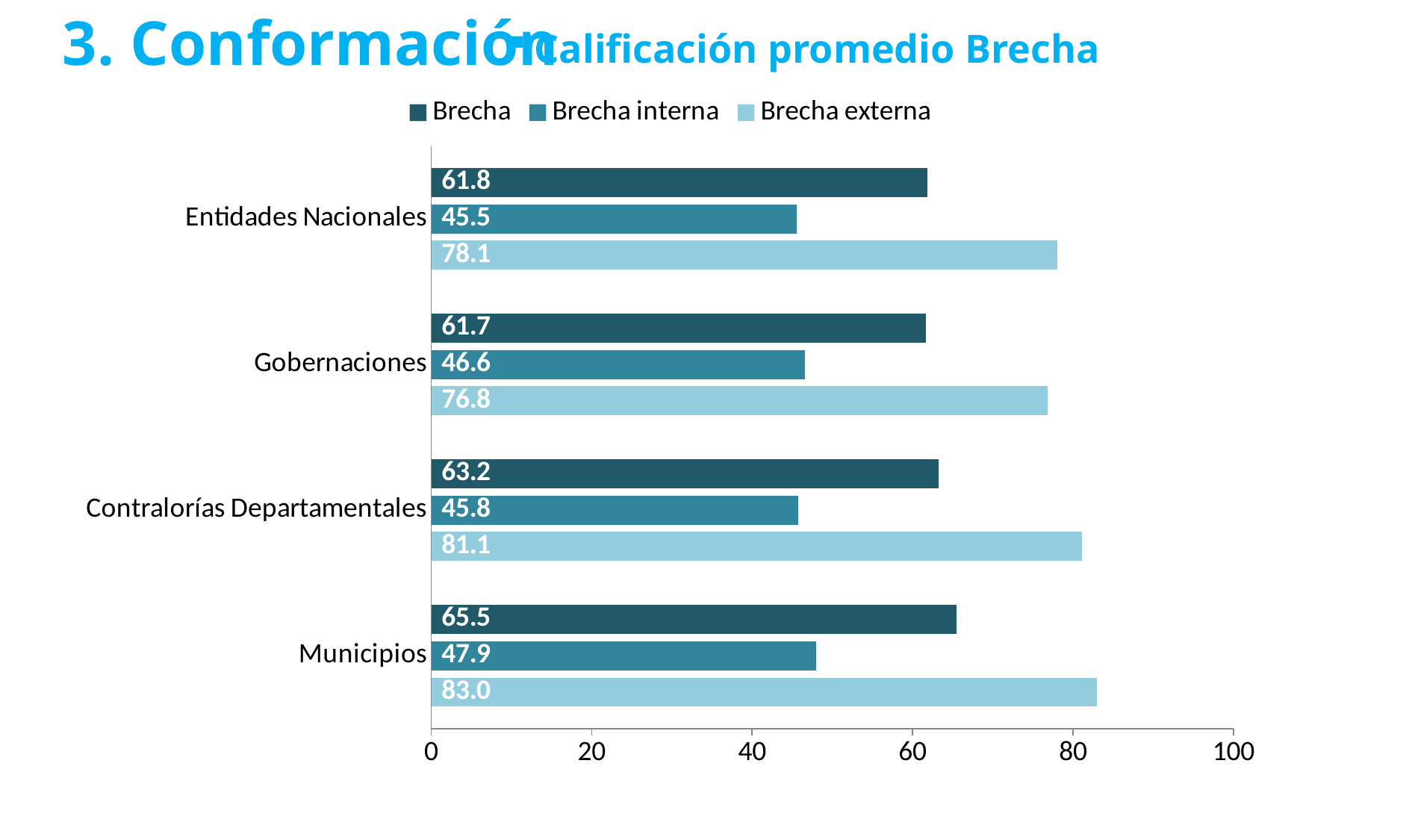
How many categories are shown on the y axis? 4 What is the difference between the Brecha externa and Brecha interna values for Gobernaciones? 30.2 Which is larger for Contralorías Departamentales: Brecha or Brecha interna? Brecha How many series does the legend list? 3 Is the Brecha externa value for Entidades Nacionales greater or less than 60? greater Which category has the lowest Brecha interna value? Entidades Nacionales What is the Brecha value for Contralorías Departamentales? 63.2 What is the title of the chart? Calificación promedio Brecha What is the Brecha externa value for Municipios? 83.0 What is the Brecha interna value for Entidades Nacionales? 45.5 What kind of chart is shown on the slide? Bar chart Which category has the highest Brecha externa value? Municipios